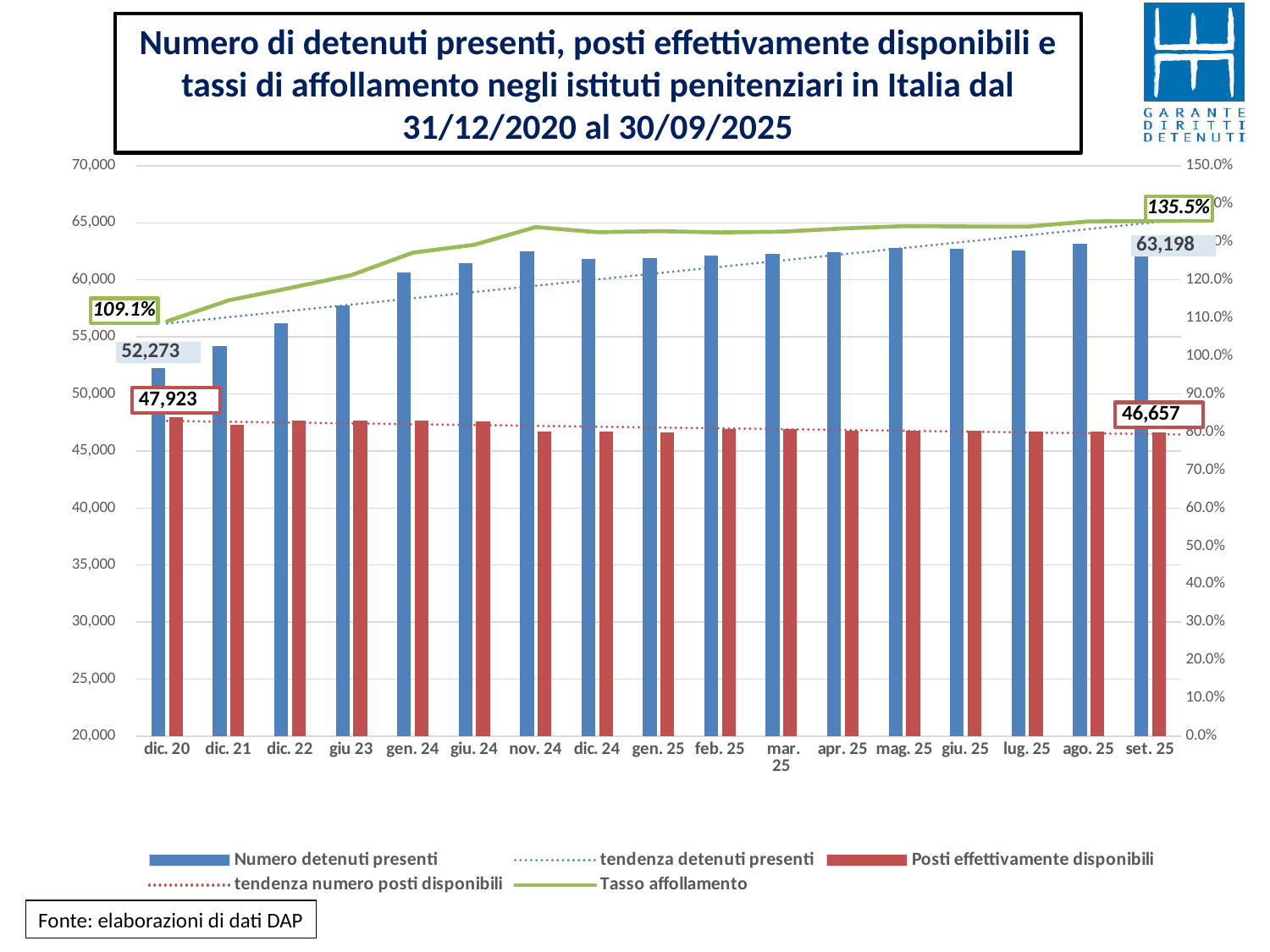
Which period has the lowest number of detenuti presenti? dic. 20 How many series does the legend list? 5 What is the tasso affollamento for dic. 20? 109.1% What is the number of detenuti presenti (blue bar) for dic. 20? 52,273 How many time periods are shown on the x axis? 17 What is the value of posti effettivamente disponibili for set. 25? 46,657 By how much did the posti effettivamente disponibili decrease from dic. 20 to set. 25? 1,266 What is the value of posti effettivamente disponibili for dic. 20? 47,923 Do the values for Numero detenuti presenti generally rise or fall from dic. 20 to set. 25? rise By how much did the number of detenuti presenti increase from dic. 20 to set. 25? 10,925 What is the number of detenuti presenti for set. 25? 63,198 What is the tasso affollamento for set. 25? 135.5%